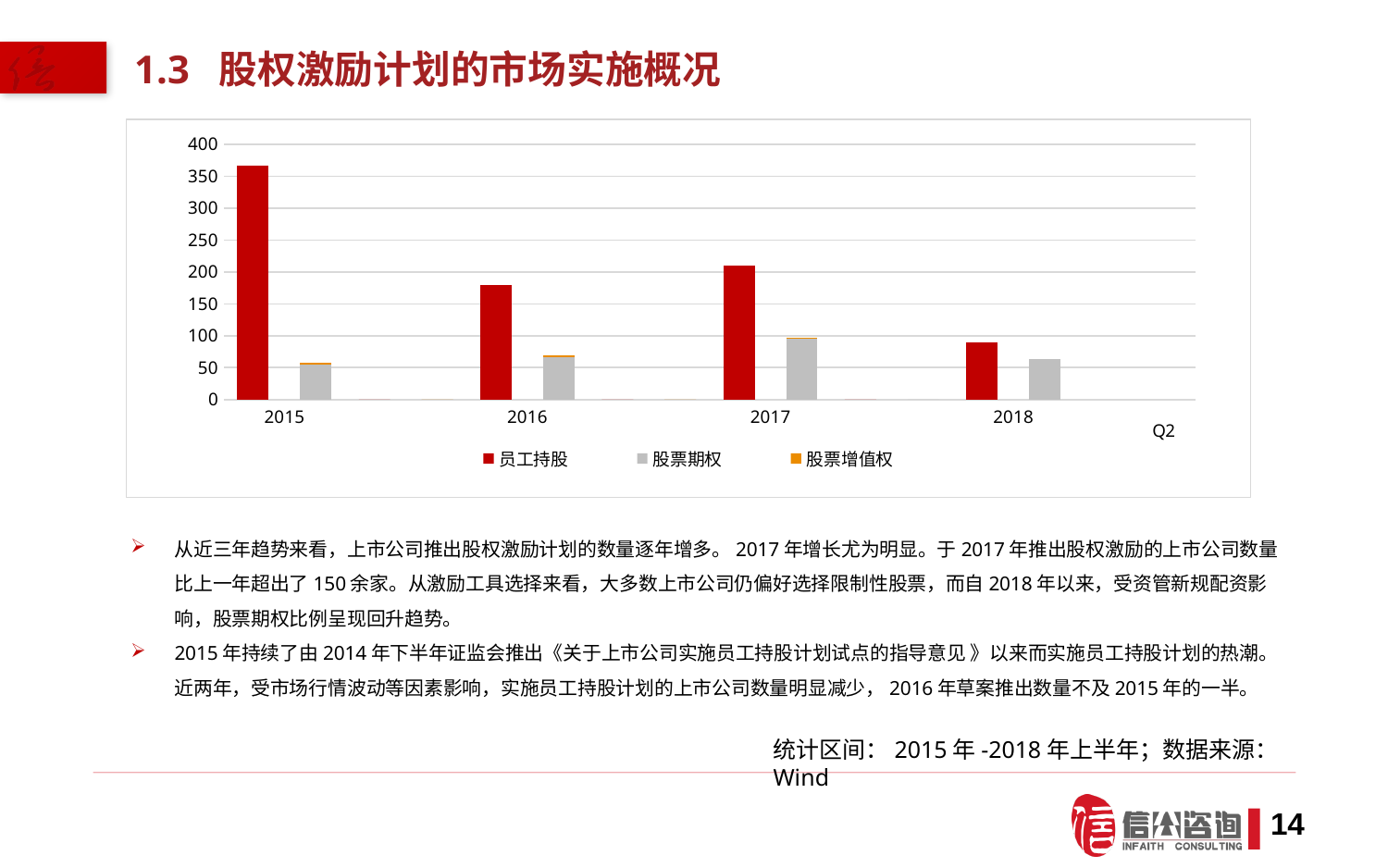
Is the value for 员工持股 in 2015 greater or less than 300? greater Which series is shown in red in the chart? 员工持股 How many years are shown on the x axis of the chart? 4 In which year is the value for 员工持股 lowest? 2018 Is the value for 股票期权 in 2018 greater or less than 100? less Is the value for 员工持股 in 2016 greater or less than 200? less In which year is the value for 员工持股 highest? 2015 How many series does the chart legend list? 3 In which year is the value for 股票期权 highest? 2017 What kind of chart is shown on the slide? bar chart Does the value for 员工持股 rise or fall from 2015 to 2016? fall Which is larger, the value for 员工持股 in 2017 or in 2016? 2017